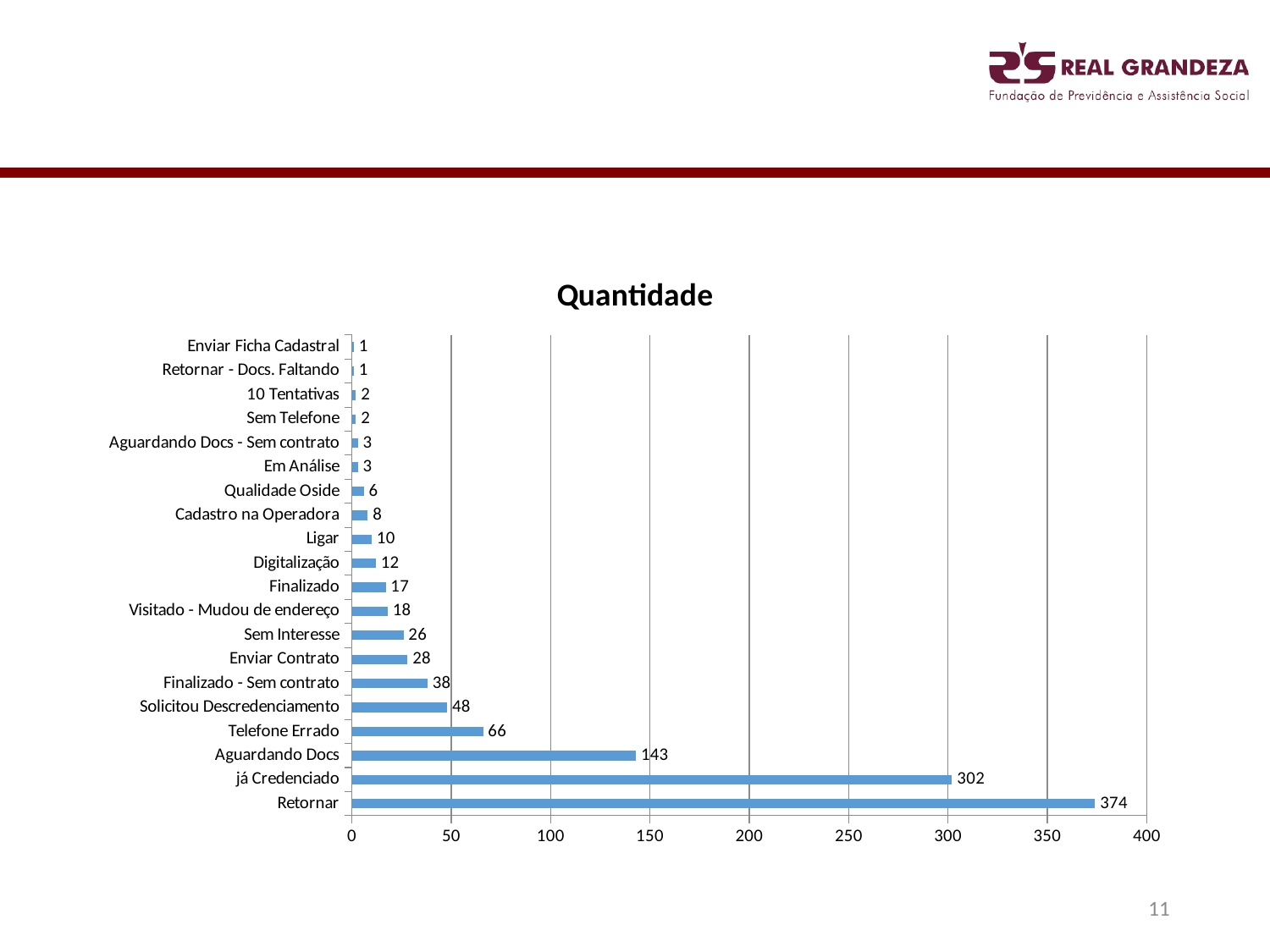
Which category has the highest value? Retornar What is the difference between the values for Aguardando Docs and Telefone Errado? 77 What is the difference between the values for Retornar and já Credenciado? 72 What is the value for Telefone Errado? 66 What kind of chart is shown on the slide? Bar chart What is the value for Aguardando Docs? 143 What is the title of the chart? Quantidade What is the value for Sem Interesse? 26 What is the value for Retornar? 374 Which is larger, the value for Finalizado - Sem contrato or the value for Enviar Contrato? Finalizado - Sem contrato Is the value for já Credenciado greater or less than 300? greater How many categories are shown in the chart? 20